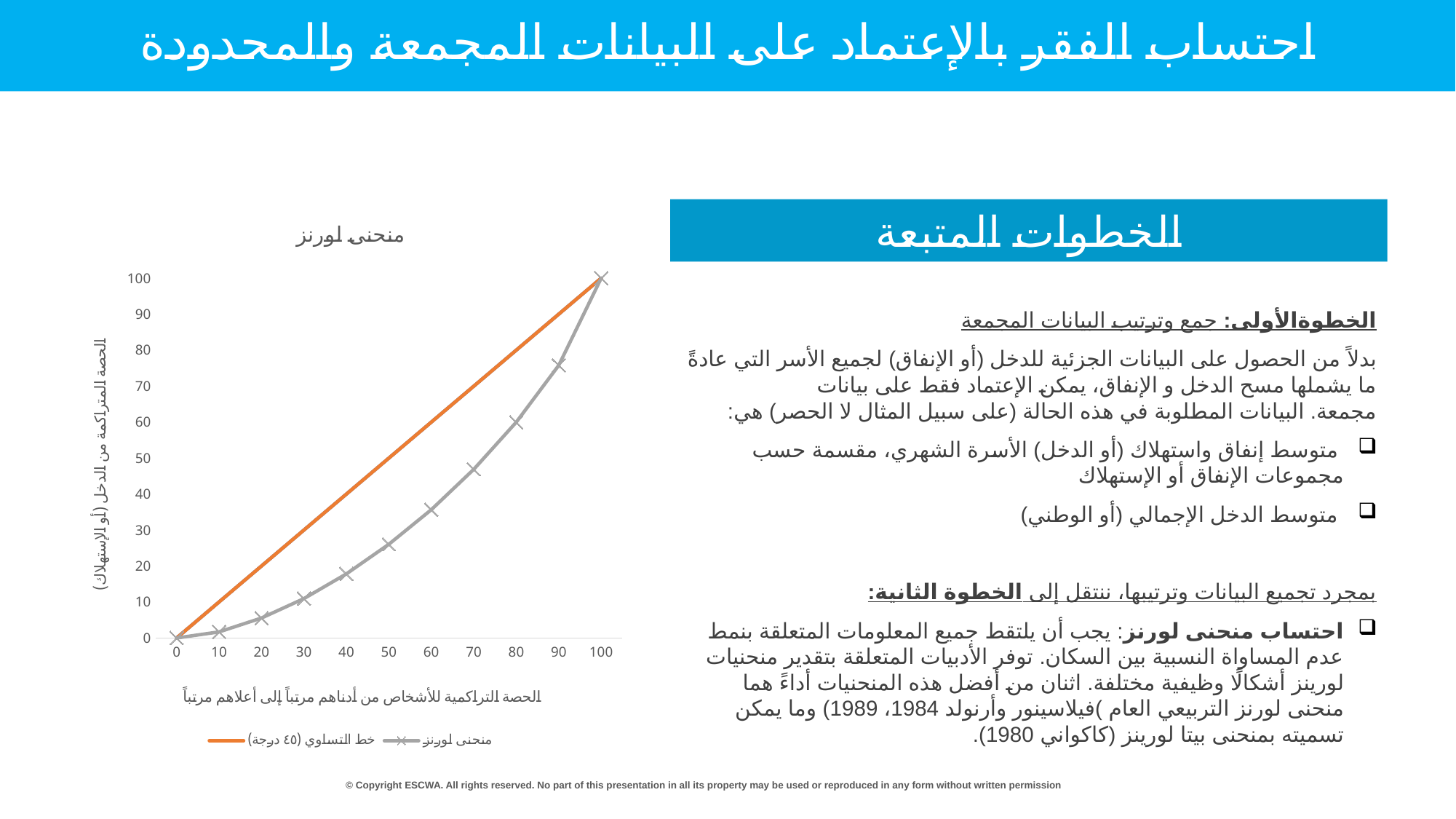
What is the value of the منحنى لورنز series at x = 0? 0 Is the value of the منحنى لورنز series at x = 30 greater or less than 20? less What is the value of the منحنى لورنز series at x = 100? 100 What kind of chart is shown on the slide? line chart How many series does the chart legend list? 2 What is the title of the chart? منحنى لورنز What colour is the line for خط التساوي (45 درجة)? orange Is the value of the منحنى لورنز series at x = 50 greater or less than 30? less At x = 50, which series has the higher value, منحنى لورنز or خط التساوي (45 درجة)? خط التساوي (45 درجة) Is the value of the منحنى لورنز series at x = 80 greater or less than 50? greater Does the منحنى لورنز series rise or fall as the x-axis value increases? rises How many data points are plotted on the منحنى لورنز series? 11